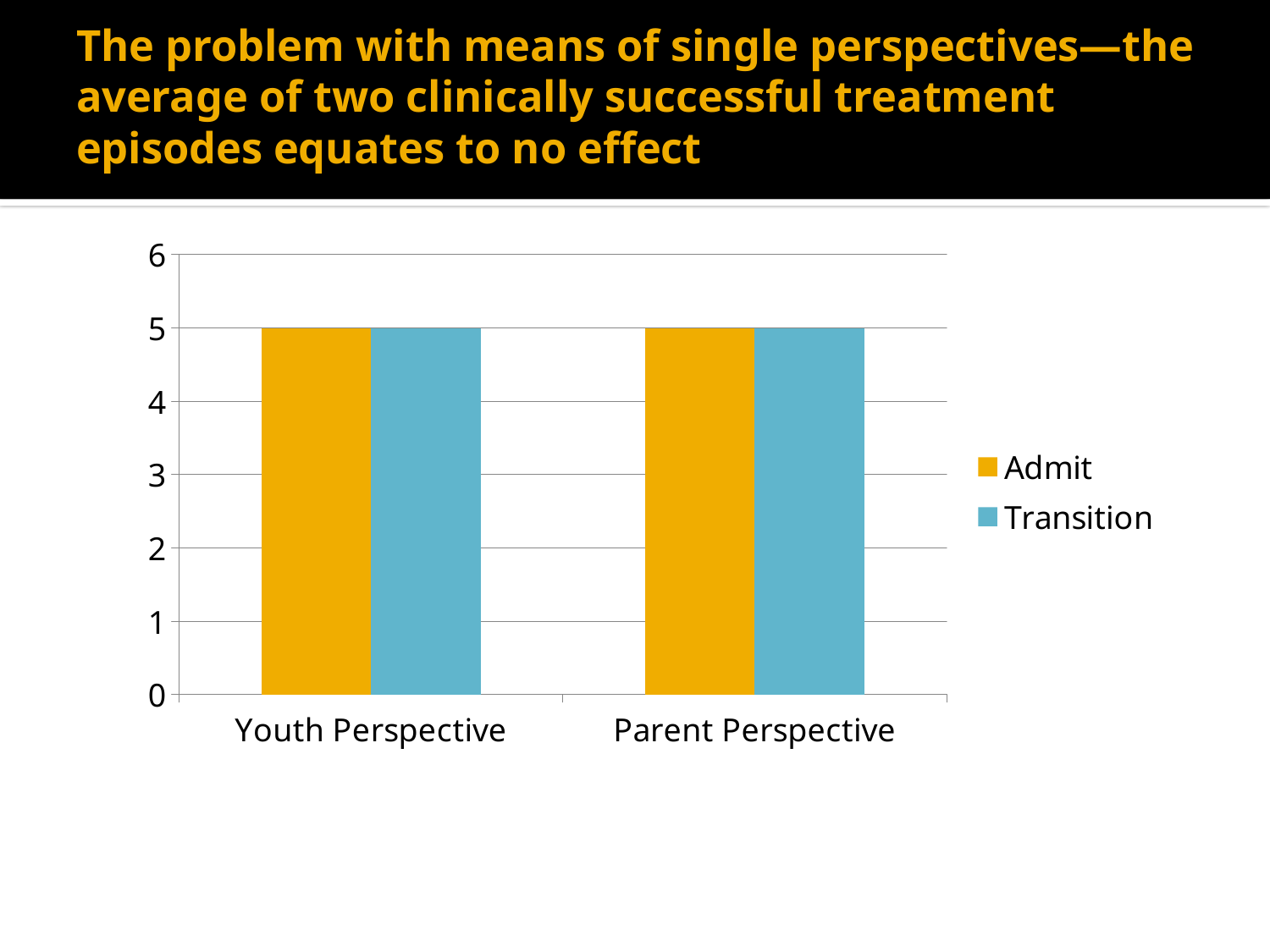
What kind of chart is shown on the slide? bar chart How many categories are shown on the x axis? 2 What is the difference between the Admit and Transition values for Youth Perspective? 0 Which series is shown in blue in the legend? Transition What is the Admit value for Youth Perspective? 5 Is the Transition value for Parent Perspective greater or less than 4? greater Is the Admit value for Youth Perspective greater or less than 6? less What is the difference between the Admit value for Youth Perspective and the Admit value for Parent Perspective? 0 What is the Admit value for Parent Perspective? 5 What is the Transition value for Youth Perspective? 5 How many series does the legend list? 2 What is the Transition value for Parent Perspective? 5